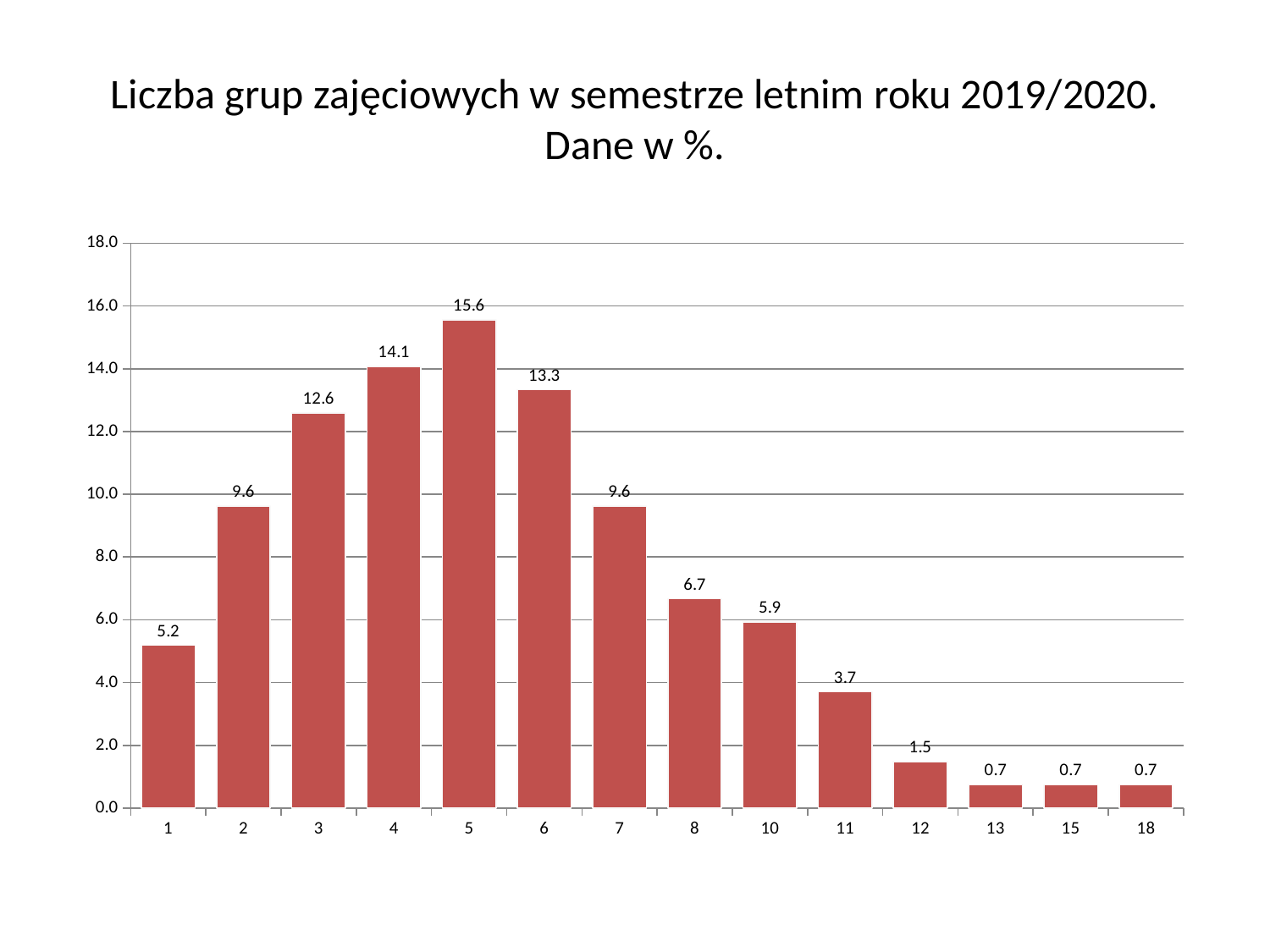
What is the difference between the values for category 3 and category 8? 5.9 What type of chart is shown on the slide? bar chart What is the value for category 5? 15.6 What is the title of the chart? Liczba grup zajęciowych w semestrze letnim roku 2019/2020. Dane w %. How many categories are shown on the x axis? 14 Do the values rise or fall from category 5 to category 18 along the x axis? fall Which category has the highest value? 5 What is the value for category 1? 5.2 Which is larger, the value for category 6 or the value for category 7? 6 What is the value for category 11? 3.7 What is the difference between the values for category 5 and category 4? 1.5 Is the value for category 4 greater or less than 14.0? greater